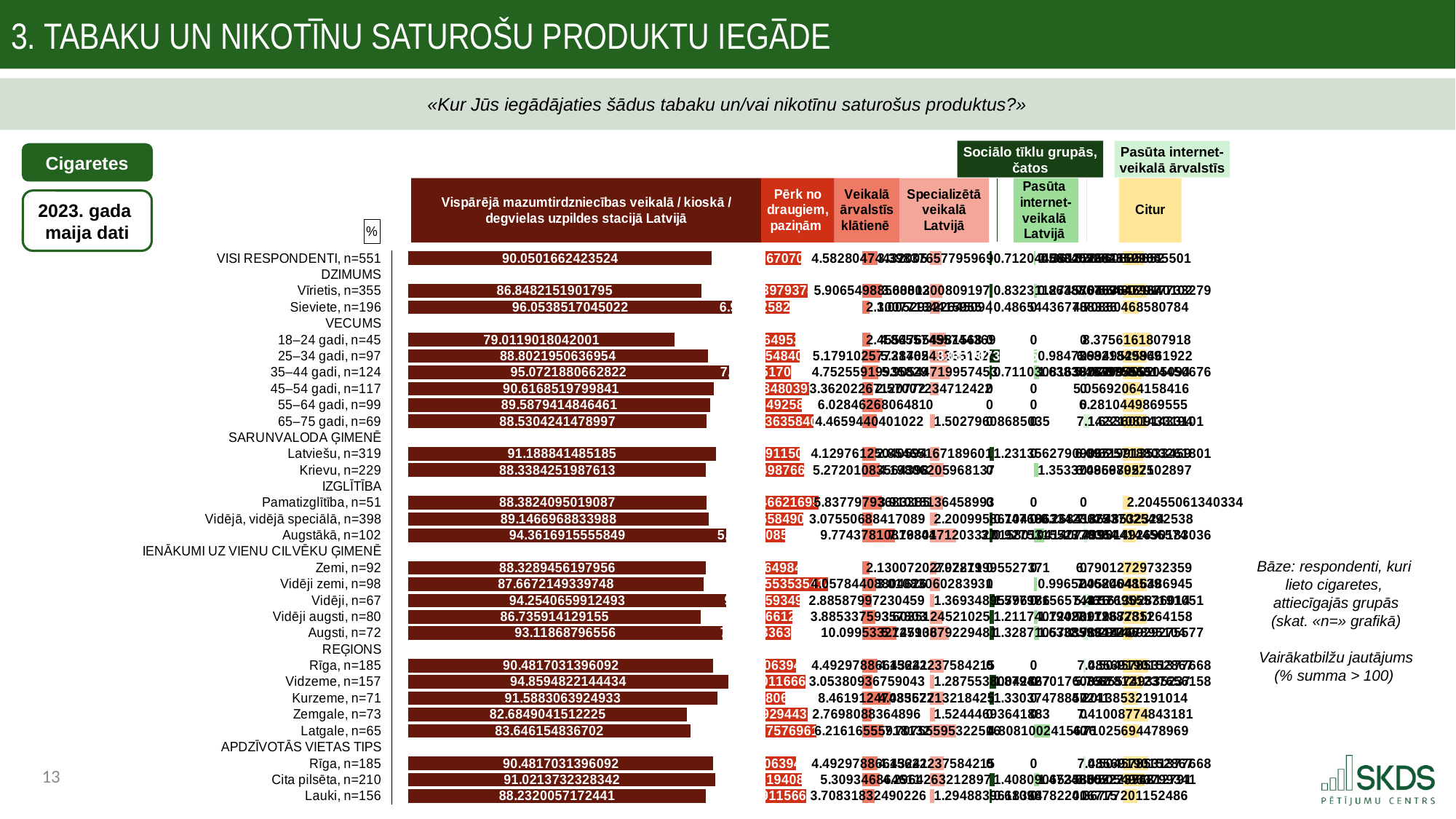
Which category has the lowest value in the series 'Vispārējā mazumtirdzniecības veikalā / kioskā / degvielas uzpildes stacijā Latvijā'? 18–24 gadi, n=45 What is the value for Zemgale, n=73 in the series 'Vispārējā mazumtirdzniecības veikalā / kioskā / degvielas uzpildes stacijā Latvijā'? 82.6849041512225 What is the value for 18–24 gadi, n=45 in the series 'Vispārējā mazumtirdzniecības veikalā / kioskā / degvielas uzpildes stacijā Latvijā'? 79.0119018042001 What is the value for Sieviete, n=196 in the series 'Vispārējā mazumtirdzniecības veikalā / kioskā / degvielas uzpildes stacijā Latvijā'? 96.0538517045022 What is the question quoted at the top of the slide? «Kur Jūs iegādājaties šādus tabaku un/vai nikotīnu saturošus produktus?» What kind of chart is shown on the slide? bar chart What is the difference between Sieviete, n=196 and Vīrietis, n=355 in the series 'Vispārējā mazumtirdzniecības veikalā / kioskā / degvielas uzpildes stacijā Latvijā'? 9.2056365143227 How many series does the legend list? 8 What is the value for VISI RESPONDENTI, n=551 in the series 'Vispārējā mazumtirdzniecības veikalā / kioskā / degvielas uzpildes stacijā Latvijā'? 90.0501662423524 In the series 'Vispārējā mazumtirdzniecības veikalā / kioskā / degvielas uzpildes stacijā Latvijā', which is larger: Latviešu, n=319 or Krievu, n=229? Latviešu, n=319 Which category has the highest value in the series 'Vispārējā mazumtirdzniecības veikalā / kioskā / degvielas uzpildes stacijā Latvijā'? Sieviete, n=196 Among the REĢIONS categories, which has the highest value in the series 'Vispārējā mazumtirdzniecības veikalā / kioskā / degvielas uzpildes stacijā Latvijā'? Vidzeme, n=157